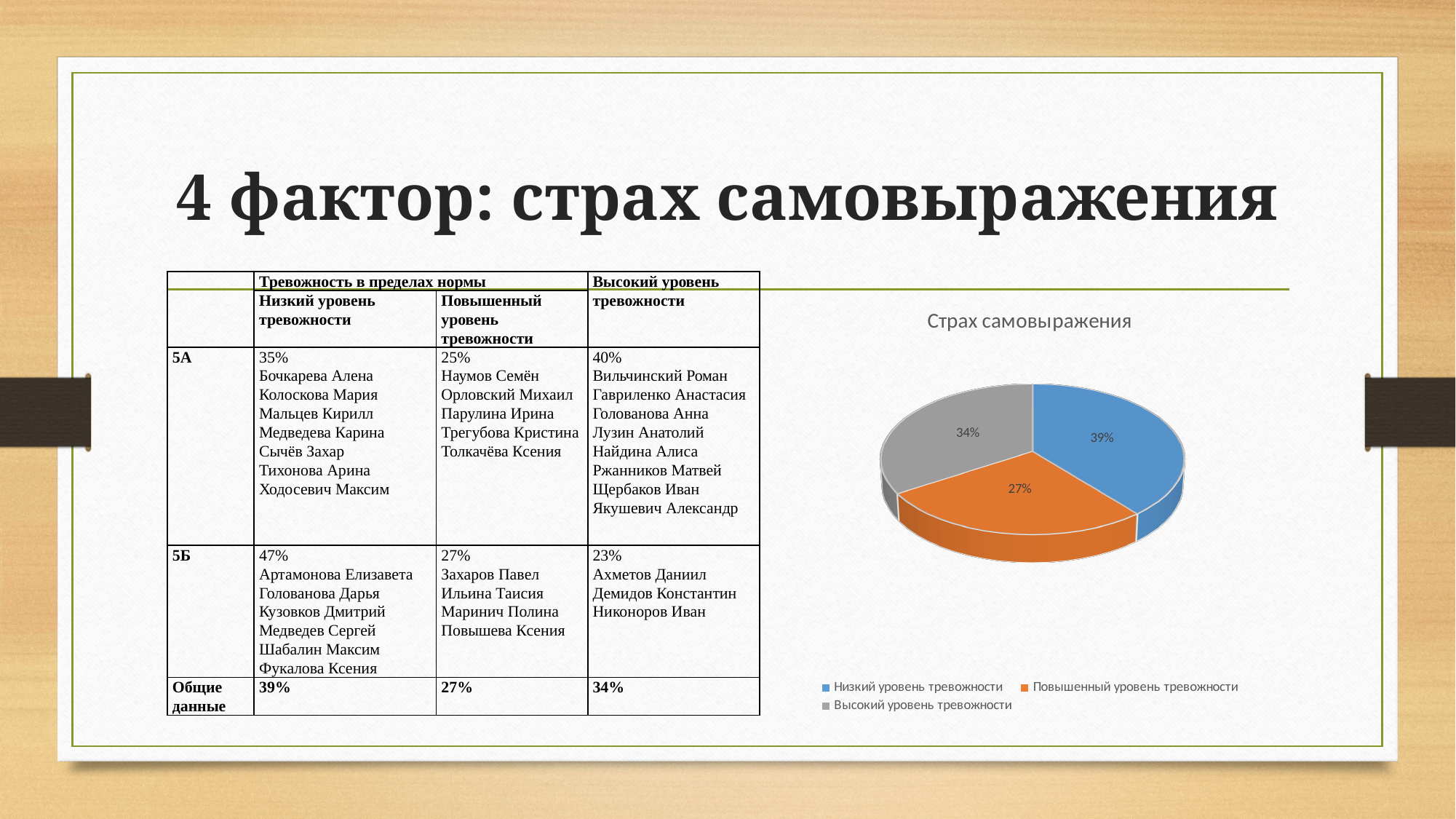
What share of the pie does "Повышенный уровень тревожности" have? 27% What share of the pie does "Высокий уровень тревожности" have? 34% Which category has the smallest slice of the pie? Повышенный уровень тревожности What kind of chart is shown on the slide? Pie chart What share of the pie does "Низкий уровень тревожности" have? 39% Which colour represents "Высокий уровень тревожности" in the pie chart? Grey What is the title of the chart? Страх самовыражения How many entries does the legend list? 3 What is the difference between the shares of "Низкий уровень тревожности" and "Повышенный уровень тревожности"? 12% Which category has the largest slice of the pie? Низкий уровень тревожности How many slices does the pie chart have? 3 Which is larger: the share for "Высокий уровень тревожности" or for "Повышенный уровень тревожности"? Высокий уровень тревожности